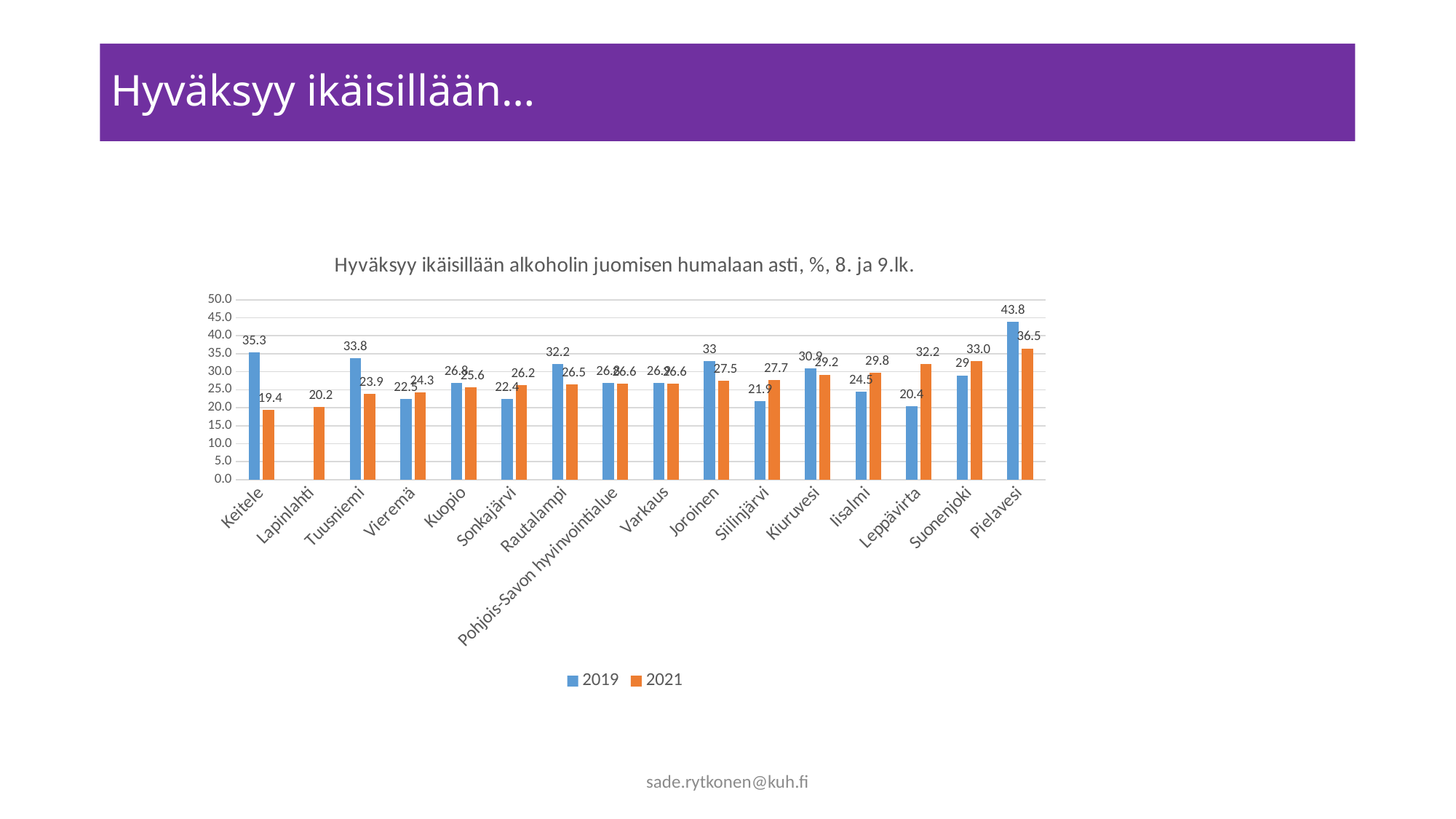
How many series does the legend list? 2 Is the 2019 value for Tuusniemi greater or less than 30.0? greater What is the title of the chart? Hyväksyy ikäisillään alkoholin juomisen humalaan asti, %, 8. ja 9.lk. How many categories are shown on the x axis? 16 What is the difference between the 2019 and 2021 values for Pielavesi? 7.3 Which category has the lowest 2021 value? Keitele What is the 2019 value for Keitele? 35.3 What type of chart is shown on the slide? bar chart What is the 2021 value for Leppävirta? 32.2 Which category has the highest 2019 value? Pielavesi What is the 2021 value for Lapinlahti? 20.2 Which is larger for Siilinjärvi, the 2019 value or the 2021 value? 2021